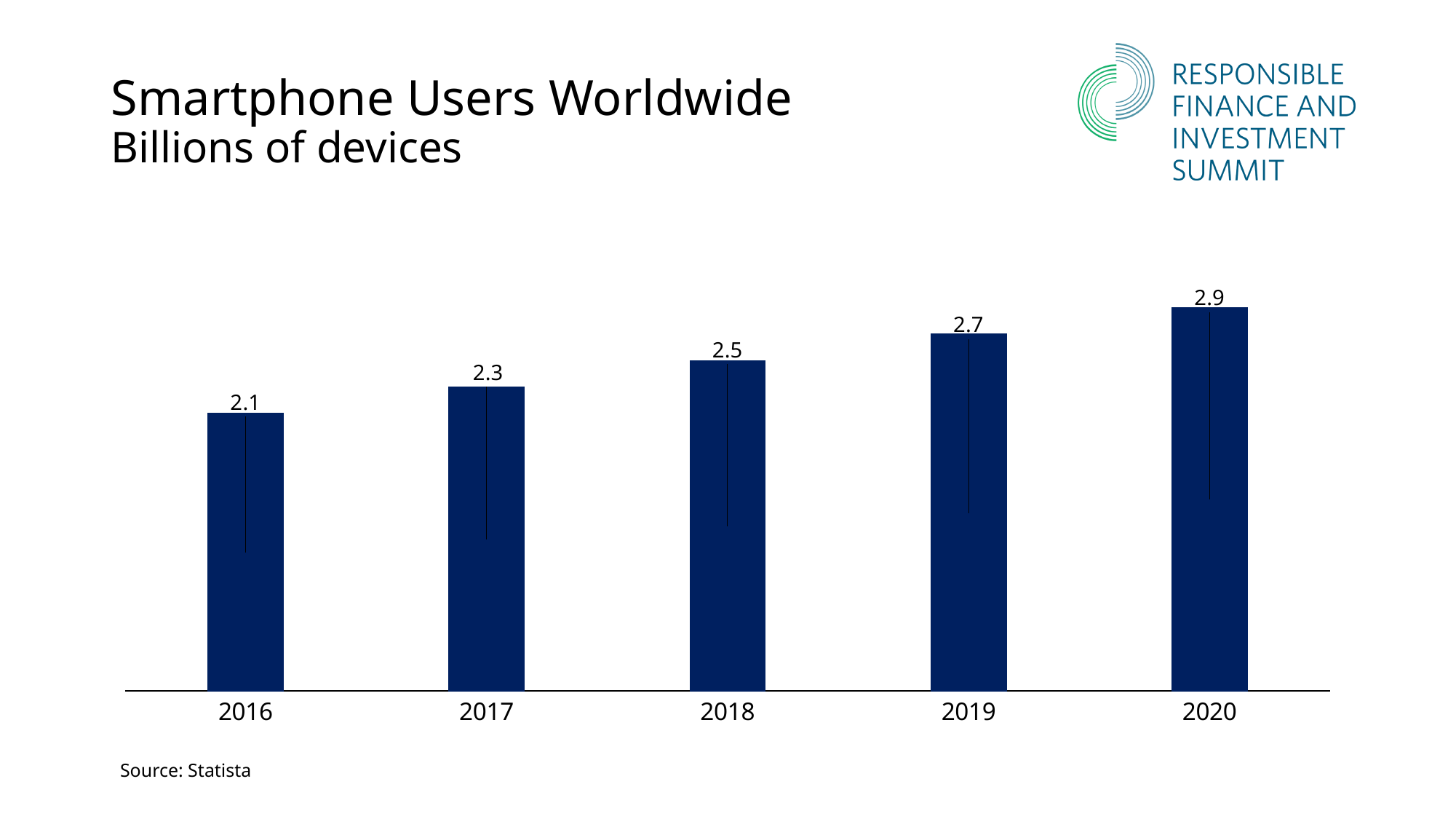
What is the value for 2018? 2.5 Which is larger, the value for 2017 or the value for 2019? 2019 What is the difference between the values for 2020 and 2016? 0.8 What is the title of the chart? Smartphone Users Worldwide What is the value for 2020? 2.9 How many years are shown on the chart? 5 What kind of chart is this? bar chart Which year has the lowest value? 2016 What is the difference between the values for 2019 and 2017? 0.4 What is the value for 2016? 2.1 Which year has the highest value? 2020 Do the values rise or fall from 2016 to 2020? rise